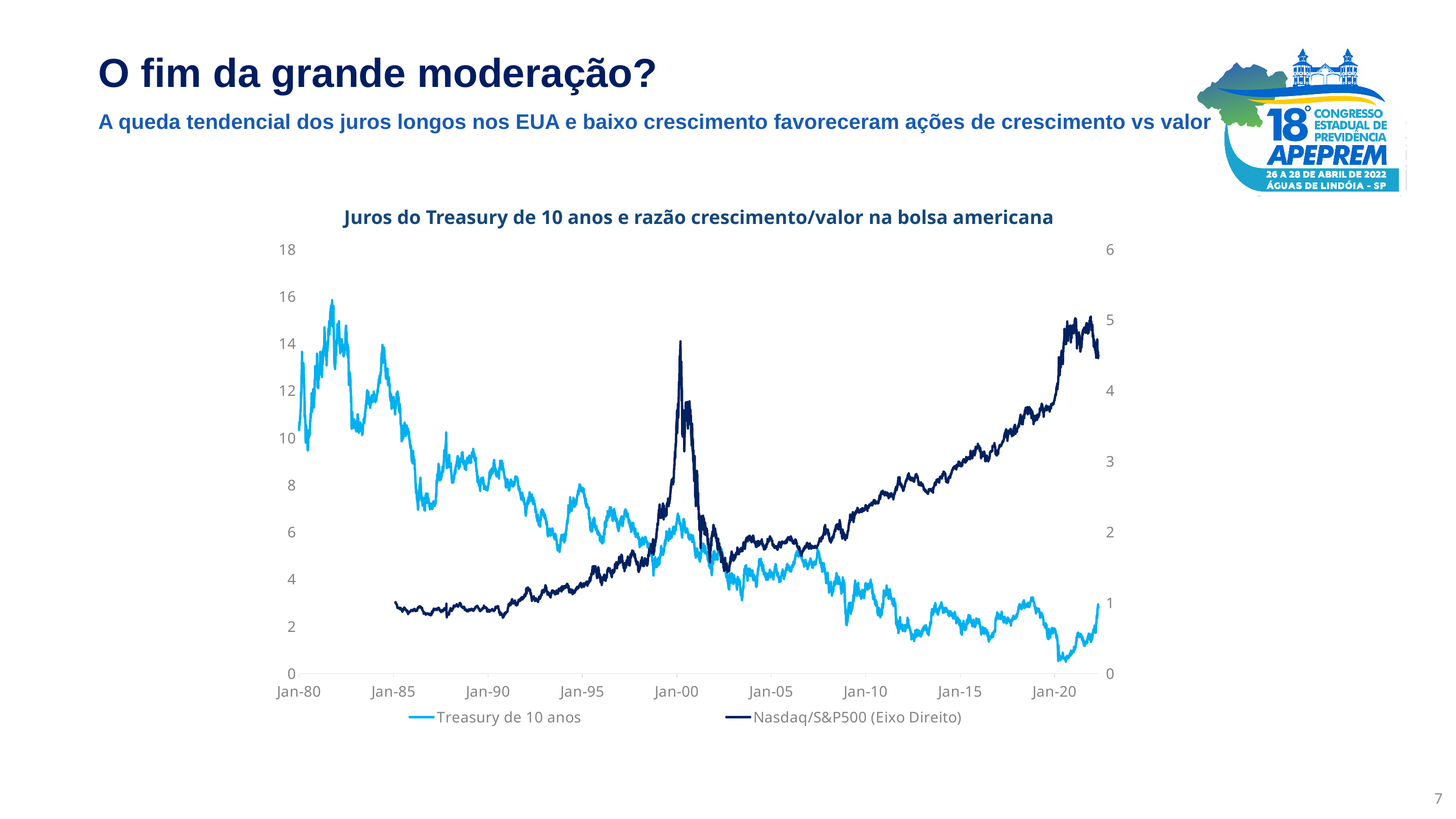
Overall, does the Nasdaq/S&P500 (Eixo Direito) series rise or fall from Jan-85 to Jan-20? rise Overall, does the Treasury de 10 anos series rise or fall from Jan-80 to Jan-20? fall Is the value for Nasdaq/S&P500 (Eixo Direito) at Jan-85 greater or less than 2? less What kind of chart is shown on the slide? line chart Is the value for Nasdaq/S&P500 (Eixo Direito) at Jan-10 greater or less than 2? greater What is the title of the chart? Juros do Treasury de 10 anos e razão crescimento/valor na bolsa americana Which series is plotted on the right axis? Nasdaq/S&P500 (Eixo Direito) How many series does the legend list? 2 Is the value for Treasury de 10 anos at Jan-00 greater or less than 4? greater